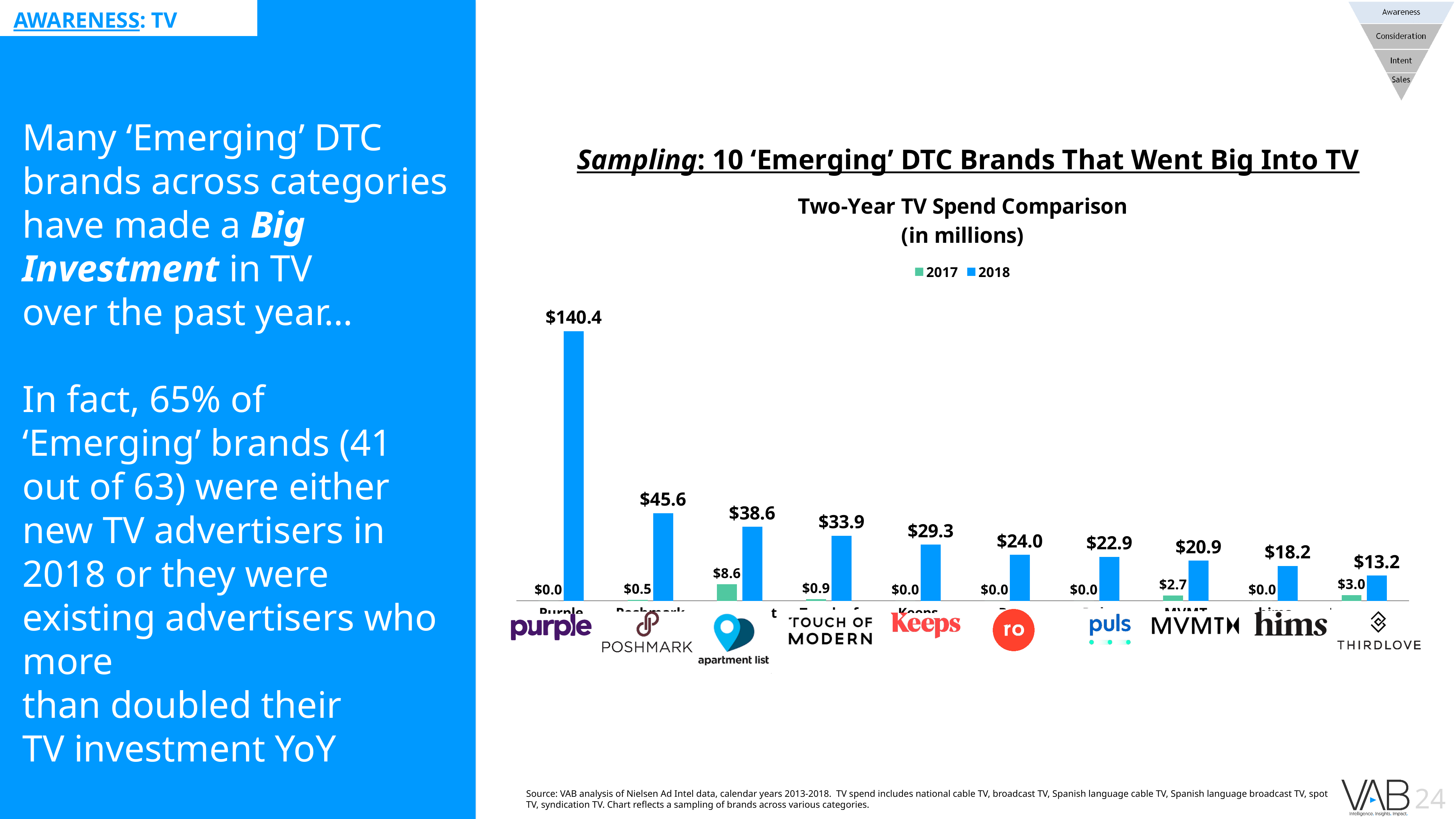
What was MVMT's 2017 TV spend according to the chart? $2.7 How many brands are shown in the Two-Year TV Spend Comparison chart? 10 How many series does the chart's legend list? 2 Which two years are compared in the chart's legend? 2017 and 2018 Which brand had a larger 2018 TV spend, Keeps or Ro? Keeps What was Poshmark's 2018 TV spend according to the chart? $45.6 What is the difference between Purple's 2018 TV spend and Poshmark's 2018 TV spend? $94.8 What was Apartment List's 2017 TV spend according to the chart? $8.6 What was Purple's 2018 TV spend in the Two-Year TV Spend Comparison chart? $140.4 What type of chart is the Two-Year TV Spend Comparison? Bar chart Which brand had the highest 2018 TV spend in the chart? Purple Which brand had the lowest 2018 TV spend in the chart? ThirdLove